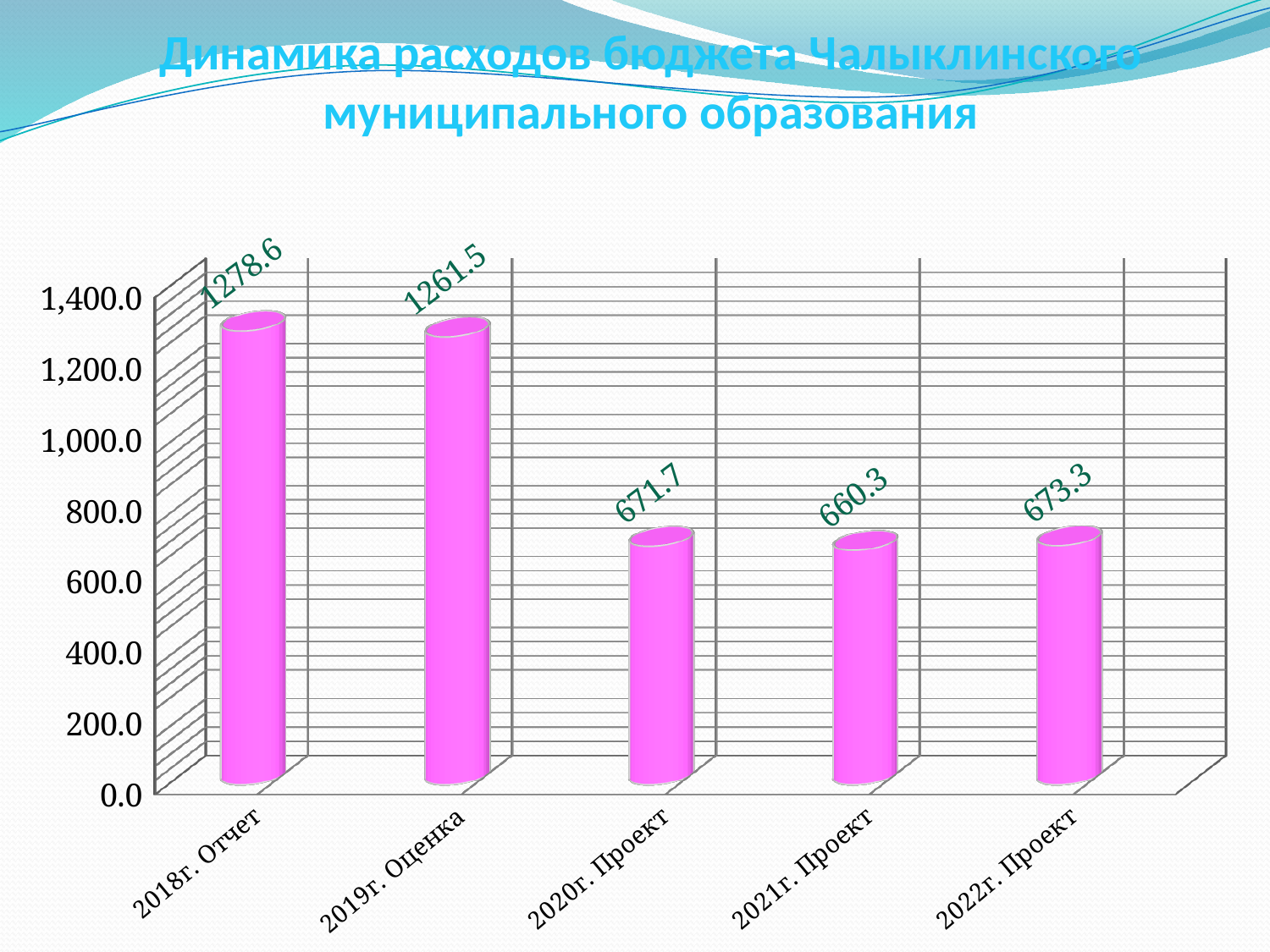
What is the difference between the values for 2019г. Оценка and 2020г. Проект? 589.8 What is the value for 2019г. Оценка? 1261.5 What is the value for 2020г. Проект? 671.7 Which category has the highest value? 2018г. Отчет Which is larger, the value for 2020г. Проект or 2022г. Проект? 2022г. Проект What is the value for 2018г. Отчет? 1278.6 How many categories are shown on the x axis? 5 What is the value for 2022г. Проект? 673.3 Which category has the lowest value? 2021г. Проект What is the value for 2021г. Проект? 660.3 What kind of chart is shown on the slide? Bar chart What is the difference between the values for 2018г. Отчет and 2019г. Оценка? 17.1